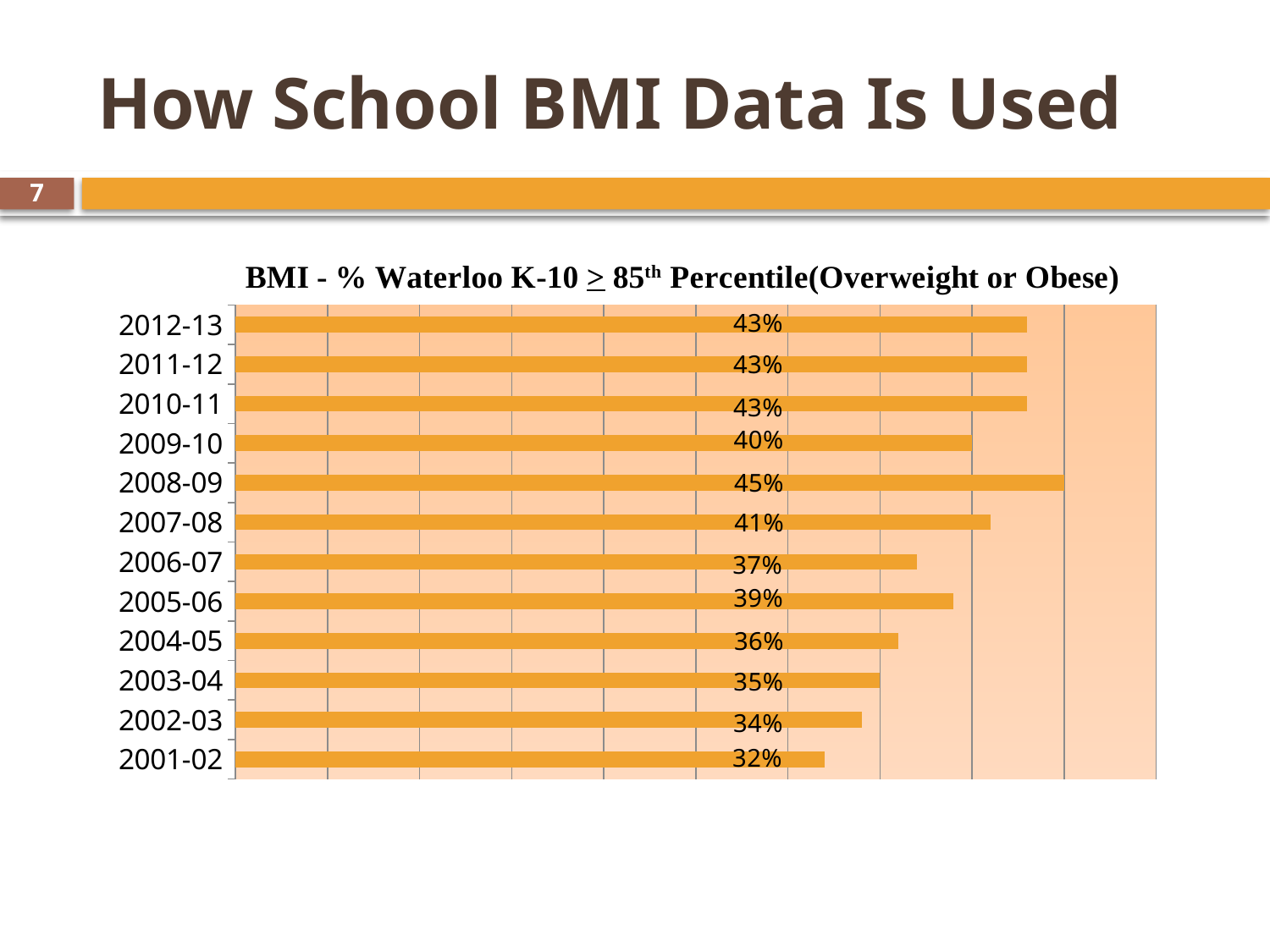
Do the values generally rise or fall from 2001-02 to 2012-13? rise How many school years are shown in the chart? 12 What is the title of the chart? BMI - % Waterloo K-10 ≥ 85th Percentile(Overweight or Obese) Which school year has the lowest value? 2001-02 What is the difference between the values for 2012-13 and 2009-10? 3% Which is larger, the value for 2005-06 or the value for 2006-07? 2005-06 What is the value for 2009-10? 40% What kind of chart is this? bar chart What is the value for 2001-02? 32% Which school year has the highest value? 2008-09 What is the difference between the values for 2008-09 and 2001-02? 13% What is the value for 2008-09? 45%